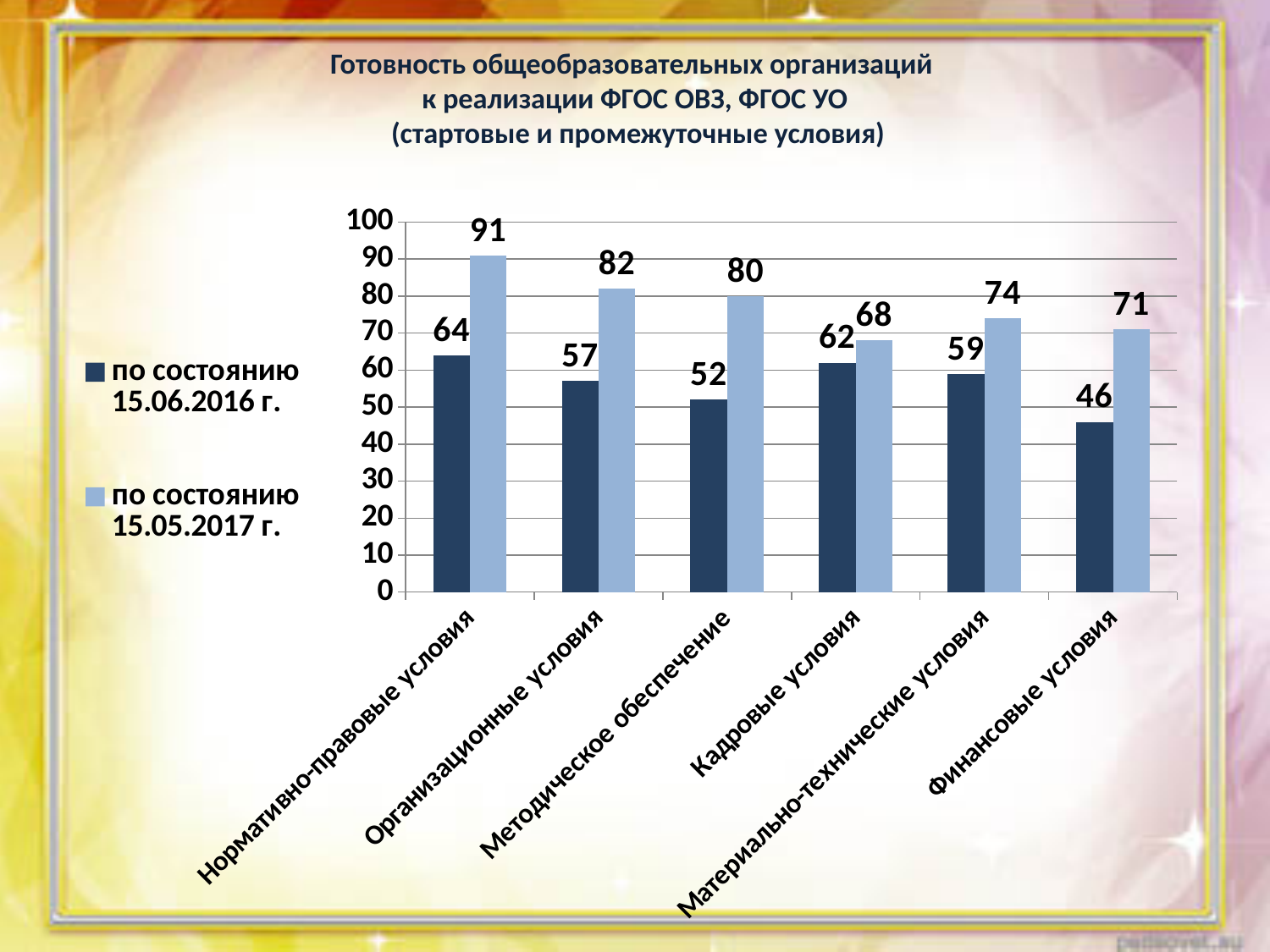
What is the value for Нормативно-правовые условия in the series по состоянию 15.05.2017 г.? 91 How many series does the legend list? 2 Which series is shown in the lighter blue colour? по состоянию 15.05.2017 г. What is the value for Методическое обеспечение in the series по состоянию 15.06.2016 г.? 52 What kind of chart is shown on the slide? bar chart Which category has the lowest value in the series по состоянию 15.06.2016 г.? Финансовые условия What is the value for Финансовые условия in the series по состоянию 15.06.2016 г.? 46 What is the difference between the 15.05.2017 and 15.06.2016 values for Методическое обеспечение? 28 Is the 15.05.2017 value for Организационные условия greater or less than 80? greater Which is larger: the 15.06.2016 value for Кадровые условия or the 15.06.2016 value for Материально-технические условия? Кадровые условия How many categories are shown on the x axis? 6 Which category has the highest value in the series по состоянию 15.05.2017 г.? Нормативно-правовые условия